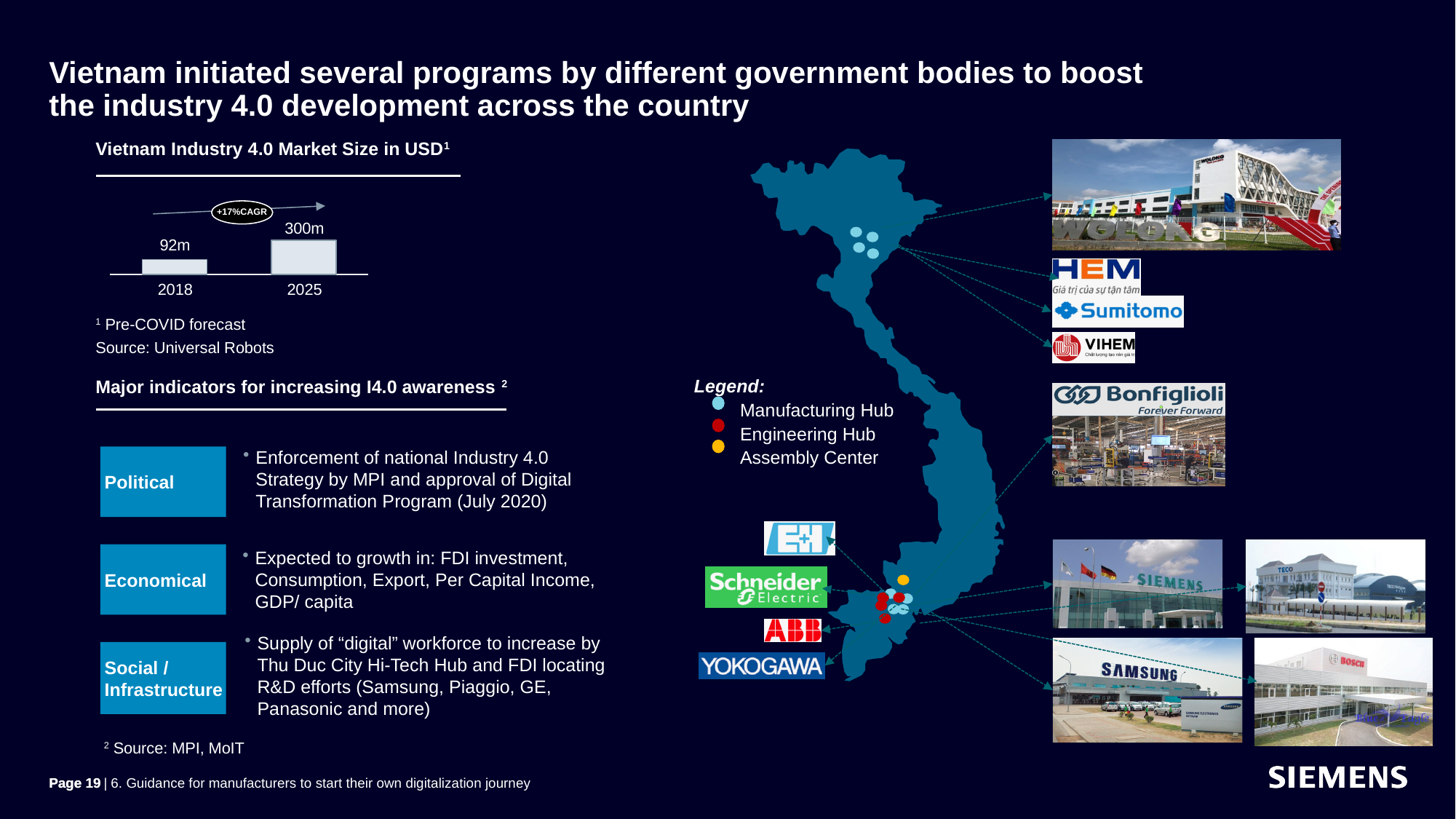
Is the market size for 2025 larger or smaller than for 2018? larger What is the Vietnam Industry 4.0 market size shown for 2018? 92m What is the Vietnam Industry 4.0 market size shown for 2025? 300m What kind of chart is used to show the Vietnam Industry 4.0 Market Size? bar chart By how much does the market size in 2025 exceed that in 2018 in the Vietnam Industry 4.0 Market Size chart? 208m Does the market size rise or fall from 2018 to 2025 in the Vietnam Industry 4.0 Market Size chart? rise How many years (bars) are plotted in the Vietnam Industry 4.0 Market Size chart? 2 What is the title of the bar chart on the slide? Vietnam Industry 4.0 Market Size in USD Which year has the smaller market size in the Vietnam Industry 4.0 Market Size chart? 2018 Which year has the larger market size in the Vietnam Industry 4.0 Market Size chart? 2025 What growth rate is annotated on the arrow in the Vietnam Industry 4.0 Market Size chart? +17% CAGR